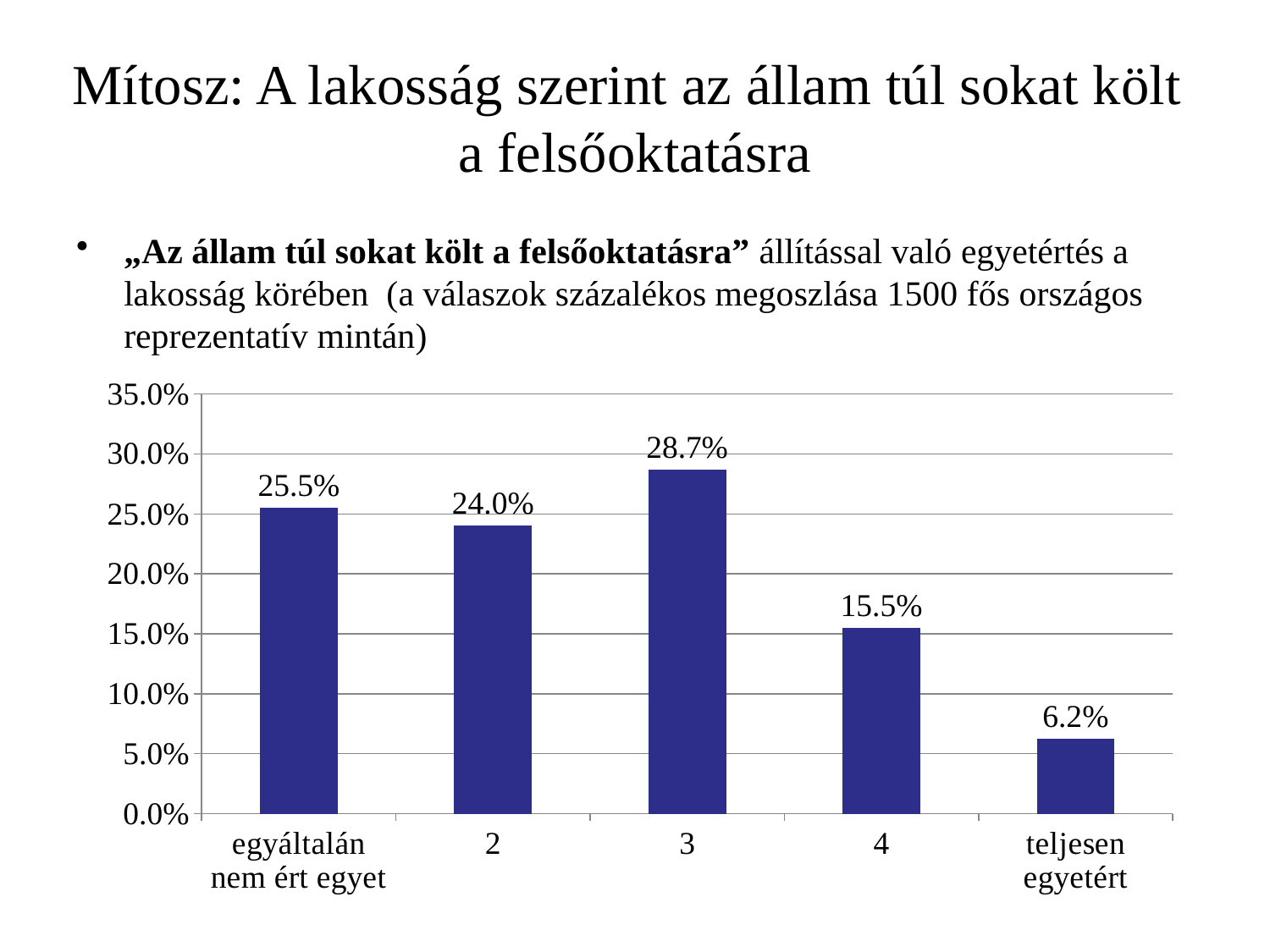
What is the value for category 3? 28.7% What is the value for the category "egyáltalán nem ért egyet"? 25.5% What is the value for the category "teljesen egyetért"? 6.2% What kind of chart is shown on the slide? bar chart What is the difference between the values for category 3 and category 2? 4.7% How many categories are shown on the x axis? 5 What is the value for category 4? 15.5% Is the value for category 4 greater or less than 20.0%? less Which category has the lowest value? teljesen egyetért Which is larger, the value for "egyáltalán nem ért egyet" or the value for category 2? egyáltalán nem ért egyet What is the difference between the values for category 4 and "teljesen egyetért"? 9.3% Which category has the highest value? 3